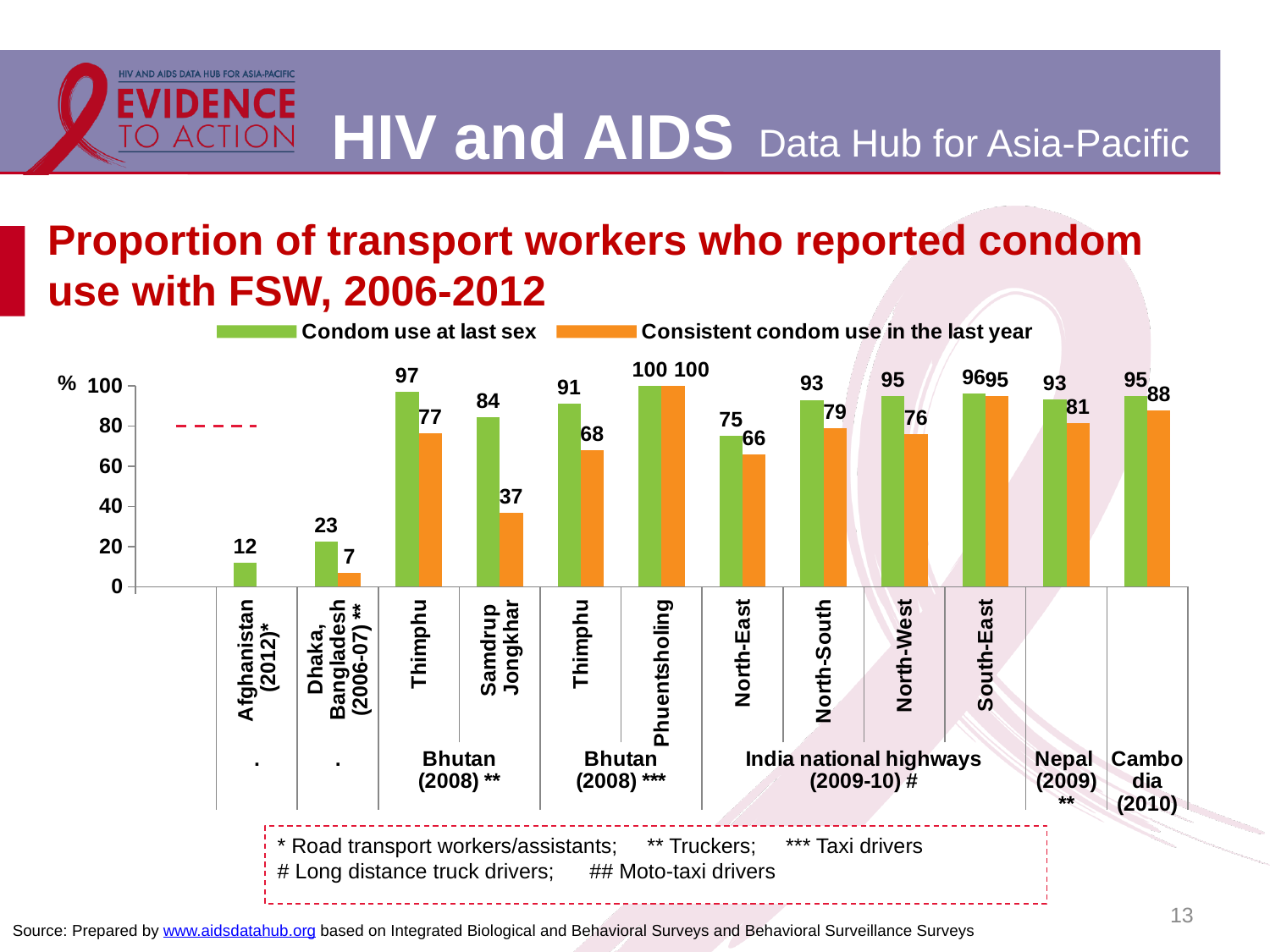
How many series does the legend list? 2 What is the value for consistent condom use in the last year in Samdrup Jongkhar, Bhutan (2008)? 37 Which has a higher value for consistent condom use in the last year, Nepal (2009) or Cambodia (2010)? Cambodia (2010) Which category has the lowest value for consistent condom use in the last year? Dhaka, Bangladesh (2006-07) Which colour represents consistent condom use in the last year in the legend? Orange In Samdrup Jongkhar, what is the difference between condom use at last sex and consistent condom use in the last year? 47 What kind of chart is shown on the slide? Bar chart What is the value for consistent condom use in the last year on the North-East India national highway? 66 How many categories are shown on the x axis of the chart? 12 What is the value for condom use at last sex in Afghanistan (2012)? 12 In Thimphu under Bhutan (2008) **, what is the difference between condom use at last sex and consistent condom use in the last year? 20 Which category has the highest value for condom use at last sex? Phuentsholing